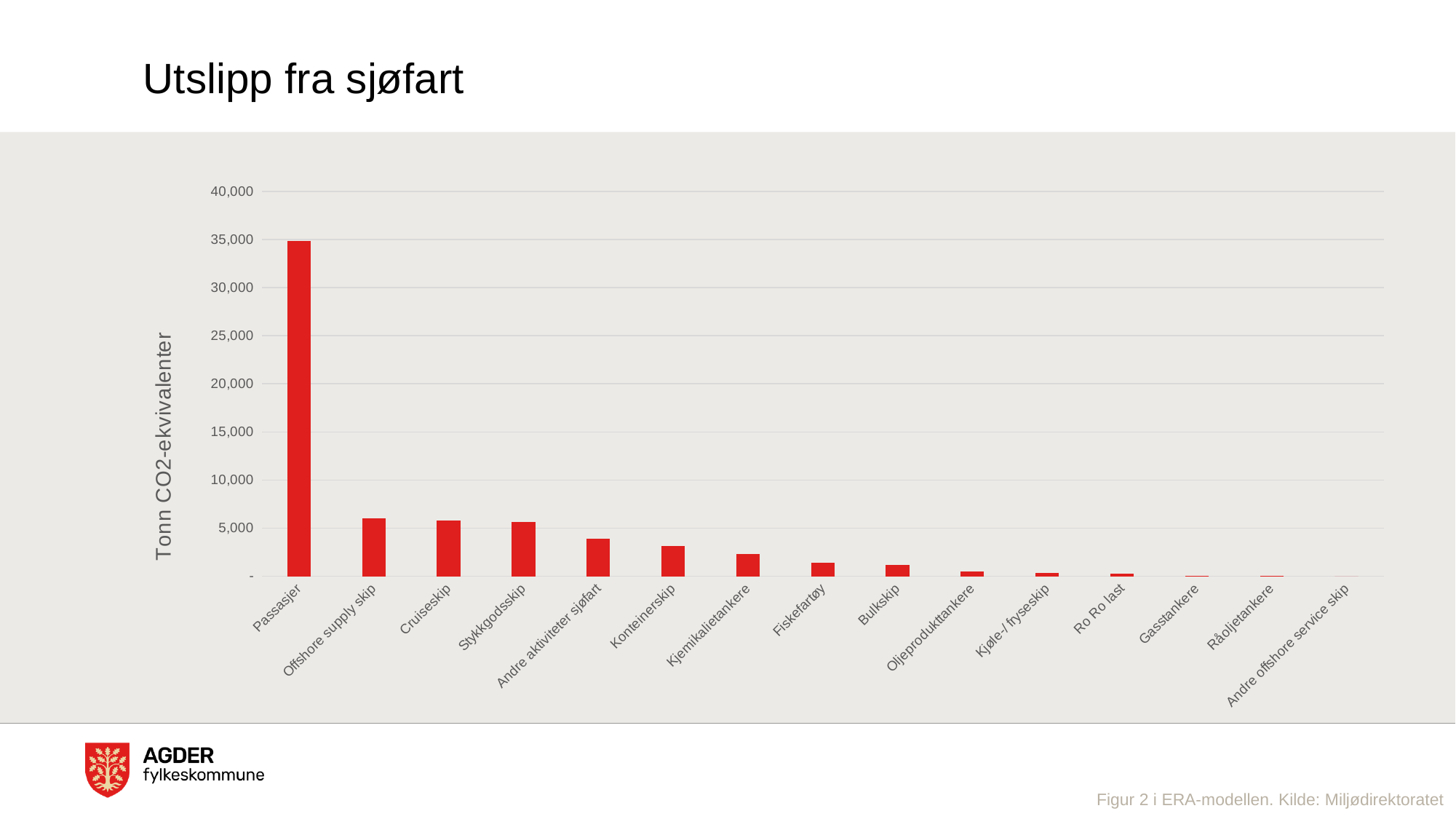
Is the value for Passasjer greater or less than 30,000? greater Which is larger, the value for Konteinerskip or the value for Kjemikalietankere? Konteinerskip Is the value for Konteinerskip greater or less than 5,000? less Which is larger, the value for Passasjer or the value for Offshore supply skip? Passasjer What is the label on the vertical axis of the chart? Tonn CO2-ekvivalenter How many categories are shown on the x axis of the chart? 15 Do the values rise or fall moving from left to right along the x axis? fall Is the value for Offshore supply skip greater or less than 5,000? greater What kind of chart is shown on the slide? bar chart Which is larger, the value for Stykkgodsskip or the value for Andre aktiviteter sjøfart? Stykkgodsskip Which category has the highest value in the chart? Passasjer